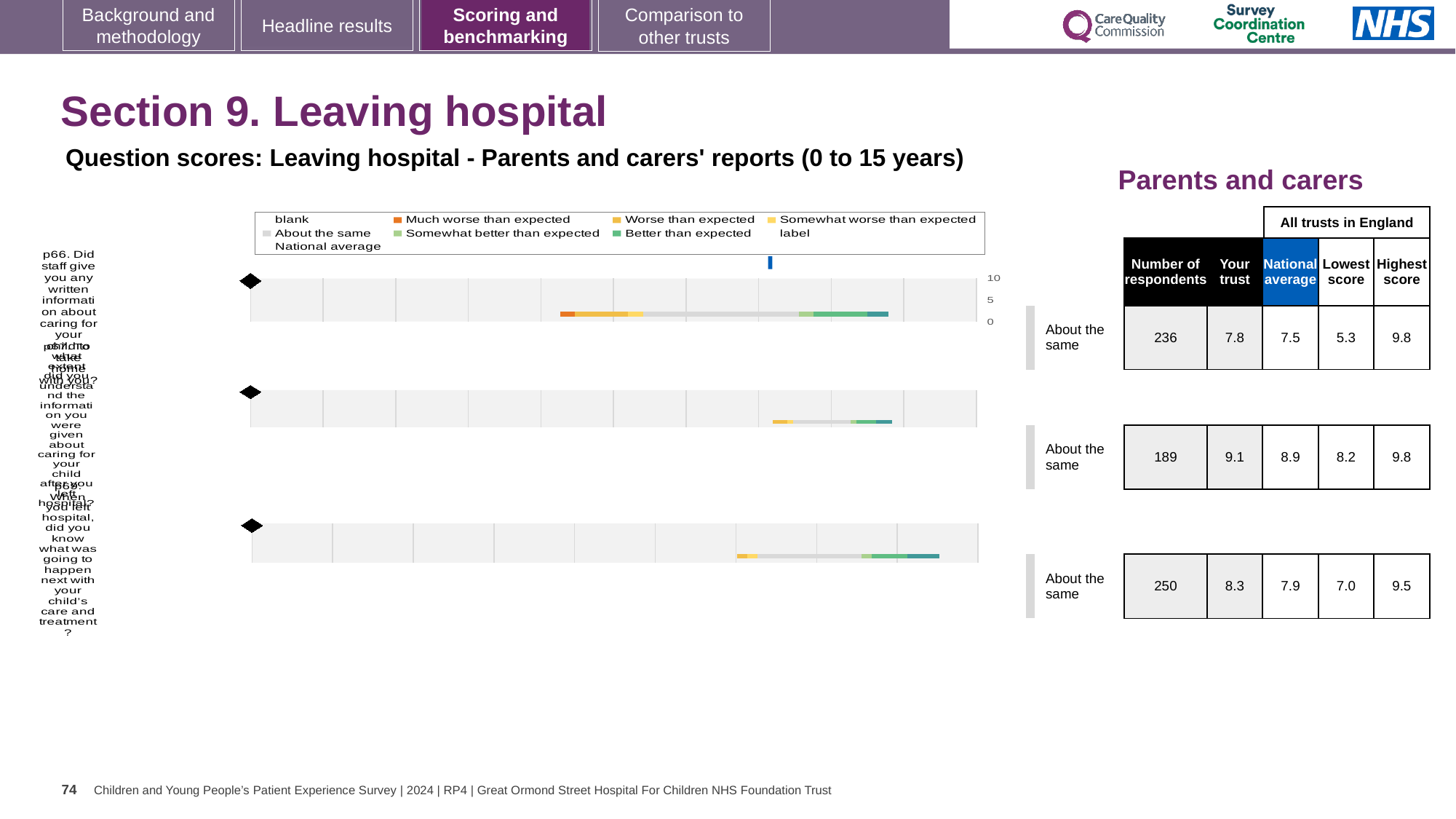
In the table, what is the "Your trust" score for the first (top) question? 7.8 How many bar charts are shown on the slide? 3 For the first (top) question, which is larger: the "Your trust" score or the national average? Your trust In the table, what is the number of respondents for the first (top) question? 236 In the table, what is the national average for the second (middle) question? 8.9 In the legend, which colour represents "Much worse than expected"? orange For the third (bottom) question, what is the difference between the "Your trust" score and the national average? 0.4 In the table, what is the lowest score for the first (top) question? 5.3 What kind of chart is used to show the question scores on this slide? bar chart Which of the three questions has the highest "Your trust" score? the second (middle) question, 9.1 In the table, what is the highest score for the third (bottom) question? 9.5 What benchmark category is shown next to all three charts? About the same